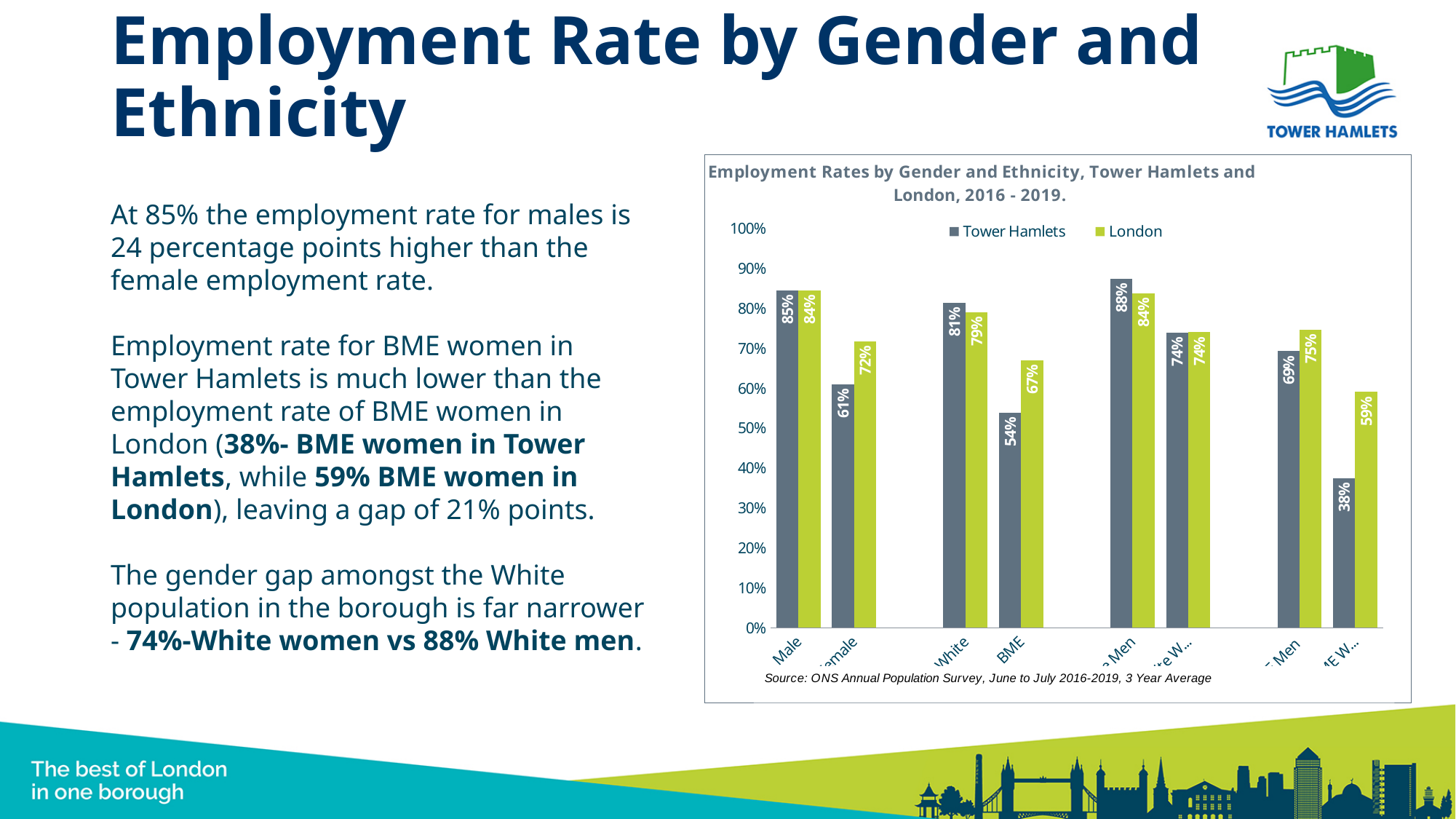
What is the highest Tower Hamlets value shown in the chart? 88% What is the lowest value shown in the chart? 38% How many categories are shown on the x axis of the chart? 8 How many series does the legend list? 2 What is the Tower Hamlets employment rate for White? 81% How many percentage points higher is the London BME employment rate than the Tower Hamlets BME rate? 13 percentage points What kind of chart is shown on the slide? Bar chart What is the London employment rate for Male? 84% For the BME category, which is higher: Tower Hamlets or London? London What is the Tower Hamlets employment rate for Male? 85% For the White category, which is higher: Tower Hamlets or London? Tower Hamlets What is the London employment rate for BME? 67%